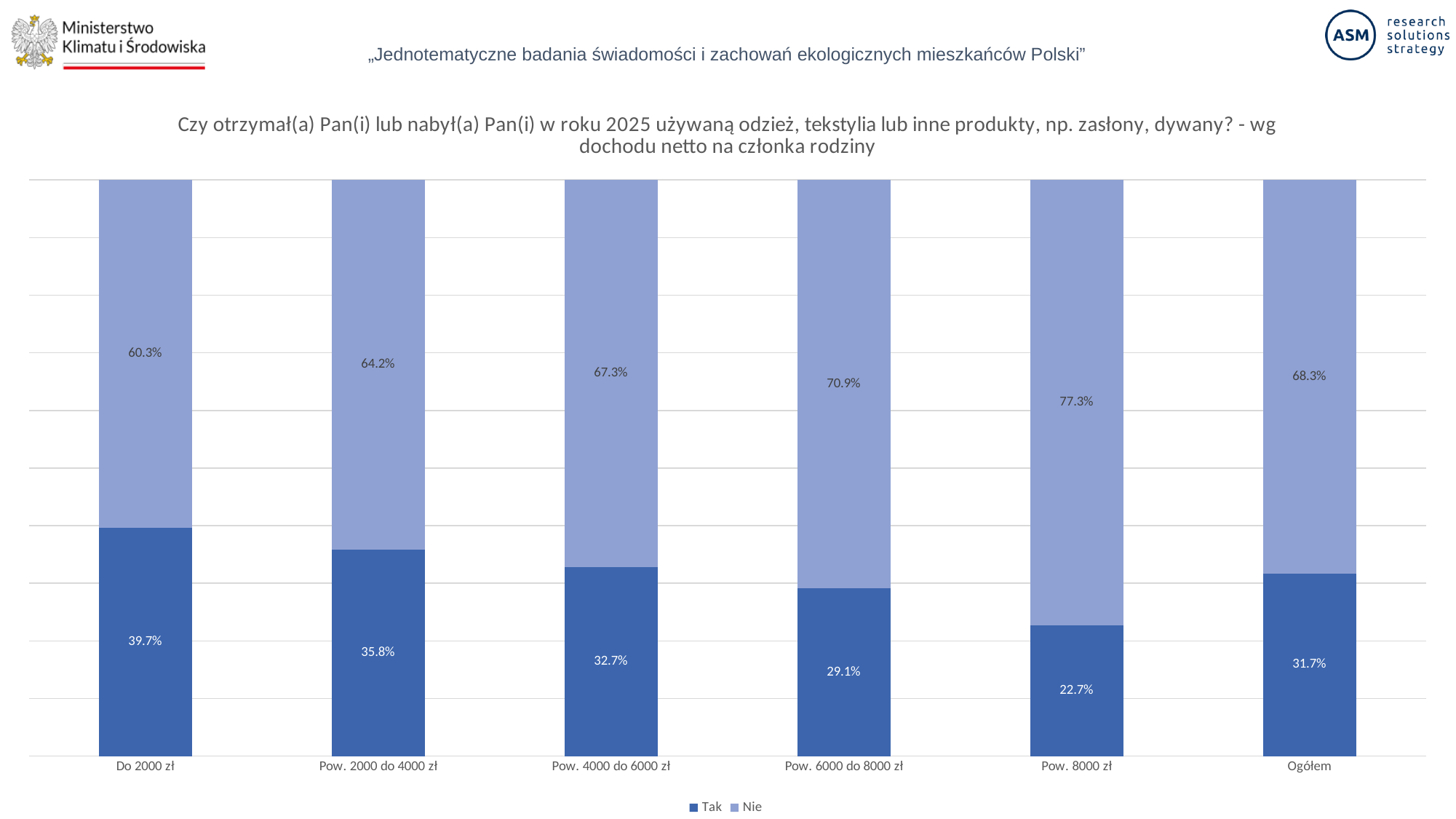
What is the 'Tak' value for 'Ogółem'? 31.7% What is the 'Nie' value for 'Pow. 8000 zł'? 77.3% How many categories are shown on the x axis? 6 Do the 'Tak' values rise or fall from 'Do 2000 zł' to 'Pow. 8000 zł'? Fall What is the difference between the 'Nie' values for 'Pow. 8000 zł' and 'Do 2000 zł'? 17.0% Which is larger: the 'Tak' value for 'Pow. 2000 do 4000 zł' or for 'Pow. 6000 do 8000 zł'? Pow. 2000 do 4000 zł Which category has the highest 'Tak' value? Do 2000 zł What kind of chart is shown on the slide? Stacked bar chart Which category has the lowest 'Tak' value? Pow. 8000 zł What is the 'Nie' value for 'Pow. 4000 do 6000 zł'? 67.3% What is the 'Tak' value for 'Do 2000 zł'? 39.7% How many series does the legend list? 2